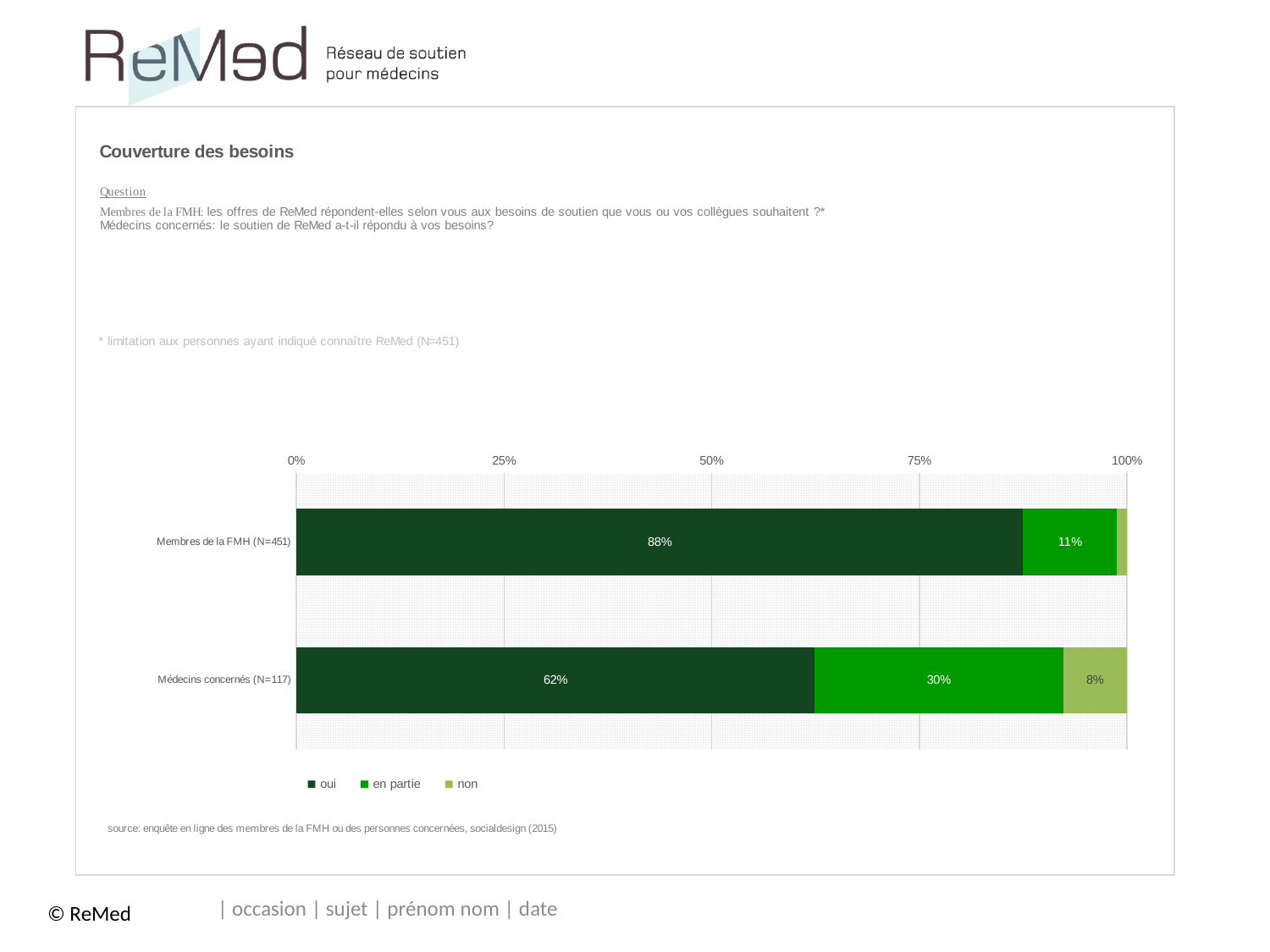
Which group has the higher "oui" share, Membres de la FMH or Médecins concernés? Membres de la FMH What type of chart is shown on the slide? Stacked bar chart What percentage of Médecins concernés (N=117) answered "en partie"? 30% What are the three legend entries of the chart? oui, en partie, non Is the "non" value for Membres de la FMH (N=451) greater or less than 25%? less What is the difference between the "oui" shares of Membres de la FMH and Médecins concernés? 26% How many groups (bars) are shown in the chart? 2 What is the "en partie" value for Membres de la FMH (N=451)? 11% What is the "non" share for Médecins concernés (N=117)? 8% How many series does the legend list? 3 What percentage of Membres de la FMH (N=451) answered "oui"? 88% How much larger is the "en partie" share for Médecins concernés than for Membres de la FMH? 19%